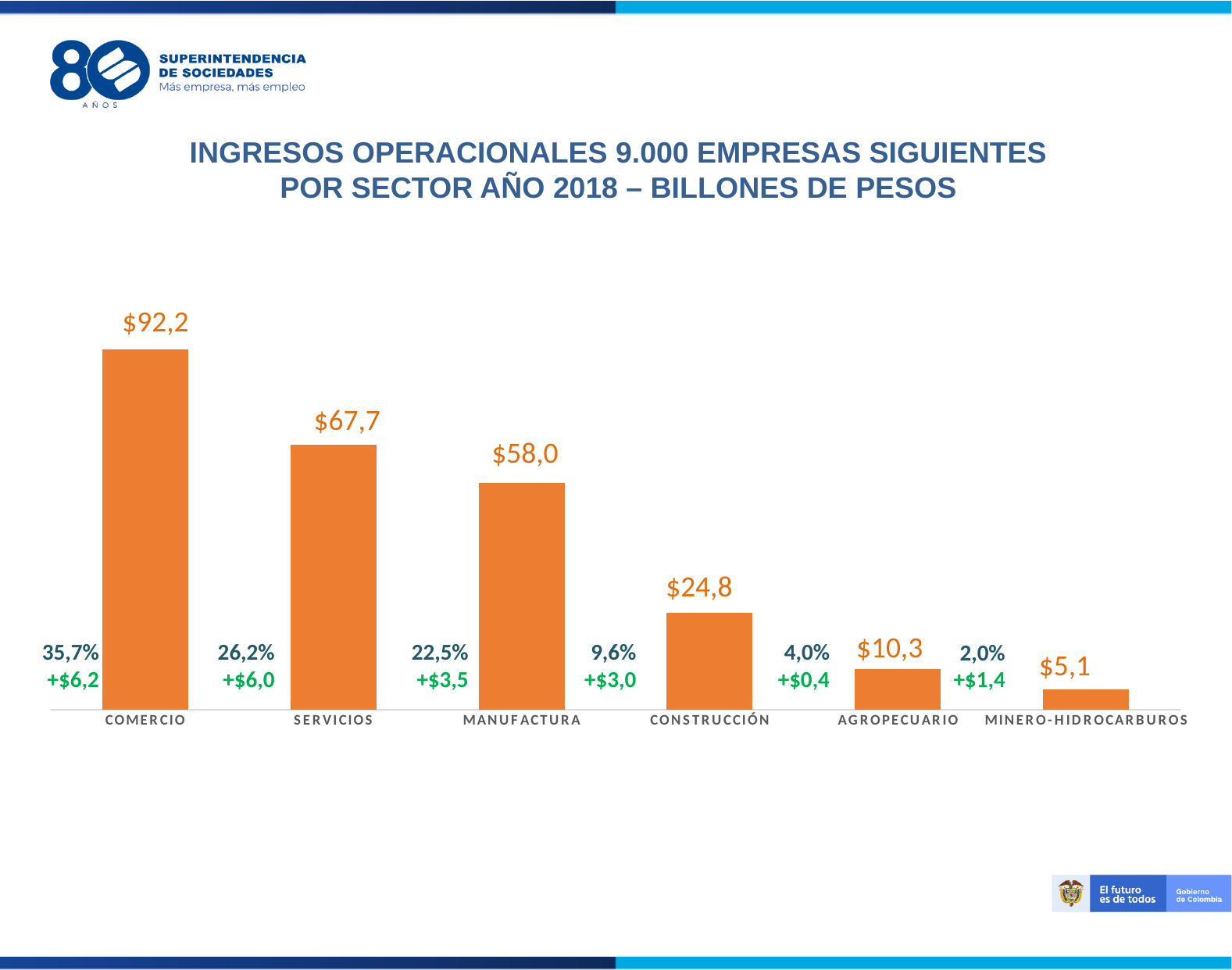
What kind of chart is shown on the slide? Bar chart Which sector has the highest value? COMERCIO Do the values rise or fall from left to right across the sectors? Fall What is the difference between the values for COMERCIO and SERVICIOS? $24,5 What is the value for COMERCIO? $92,2 How many sectors are shown in the chart? 6 What percentage is shown next to the SERVICIOS bar? 26,2% Which sector has the lowest value? MINERO-HIDROCARBUROS What is the difference between the values for CONSTRUCCIÓN and AGROPECUARIO? $14,5 What is the value for MANUFACTURA? $58,0 What is the value for AGROPECUARIO? $10,3 Which is larger, the value for SERVICIOS or the value for MANUFACTURA? SERVICIOS